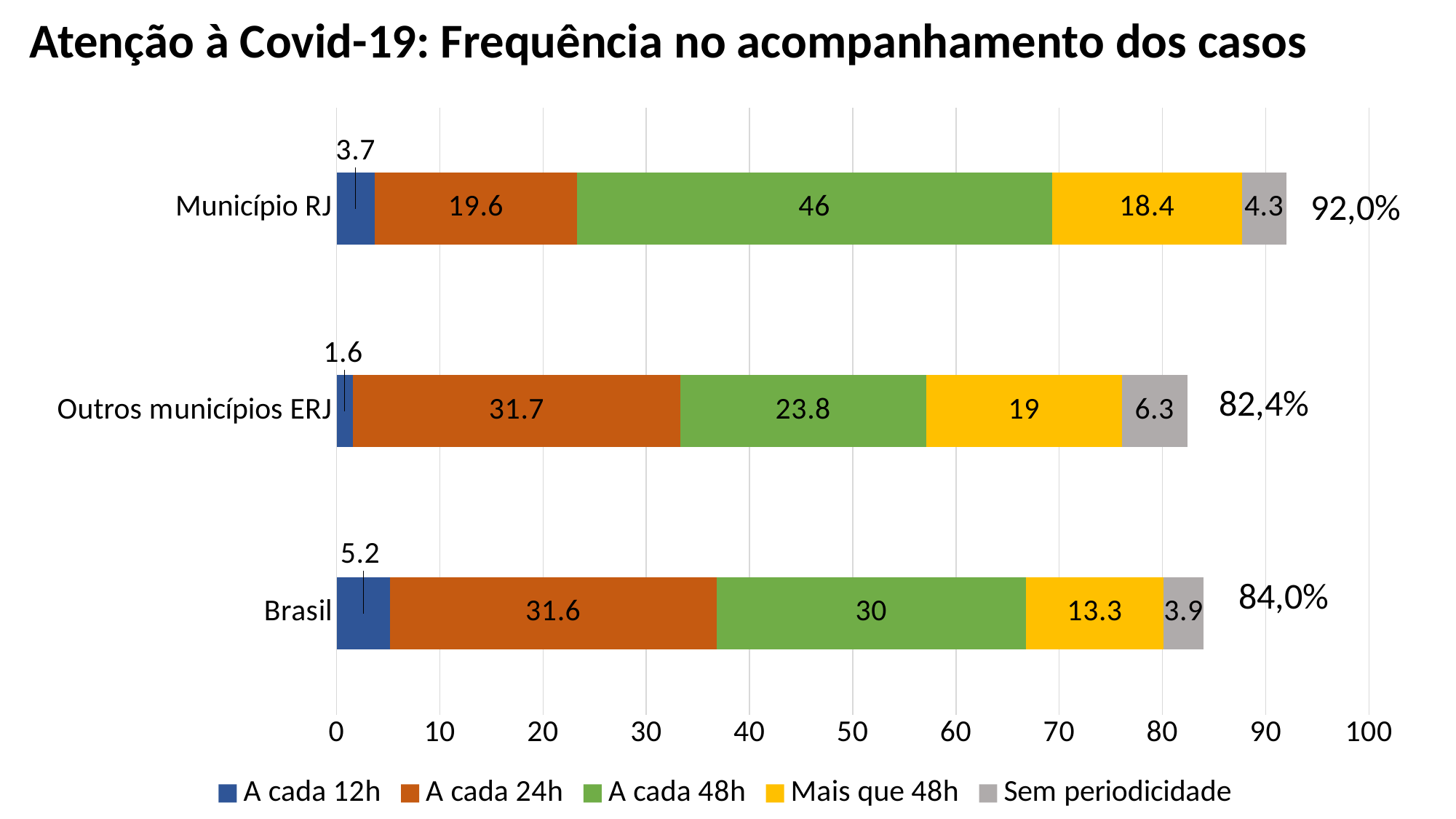
What is the value of 'Sem periodicidade' for Outros municípios ERJ? 6.3 Which is larger: 'Mais que 48h' for Outros municípios ERJ or for Brasil? Outros municípios ERJ What is the value of 'A cada 48h' for Município RJ? 46 How many series does the legend list? 5 How many categories are shown on the y axis? 3 What is the value of 'A cada 24h' for Outros municípios ERJ? 31.7 What is the difference between the 'A cada 24h' values for Outros municípios ERJ and Município RJ? 12.1 Which category has the lowest value for 'A cada 12h'? Outros municípios ERJ Which category has the highest value for 'A cada 48h'? Município RJ What kind of chart is shown on the slide? Stacked bar chart What is the total shown for the Município RJ bar? 92,0% What is the value of 'A cada 12h' for Brasil? 5.2